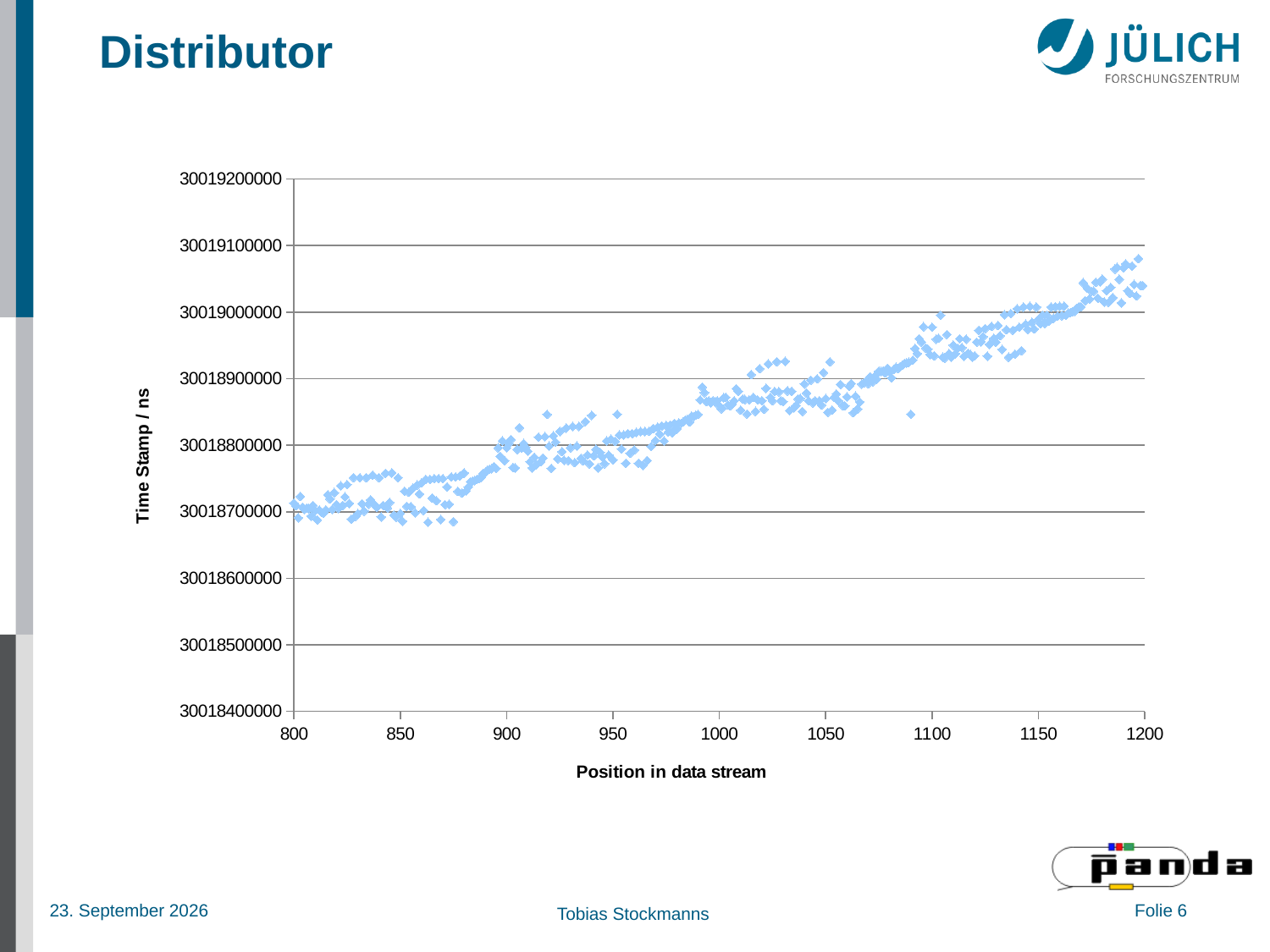
Are the time stamp values around position 1100 greater or less than 30018900000? greater Are the time stamp values around position 1200 greater or less than 30018900000? greater Are the time stamp values around position 900 greater or less than 30018900000? less What is the highest value shown on the x axis? 1200 What kind of chart is shown on the slide? scatter chart What is the lowest value shown on the y axis? 30018400000 Do the time stamp values rise or fall as the position in the data stream increases from 800 to 1200? rise Are the time stamps at position 1200 larger or smaller than those at position 800? larger What is the label of the y axis? Time Stamp / ns What is the label of the x axis? Position in data stream